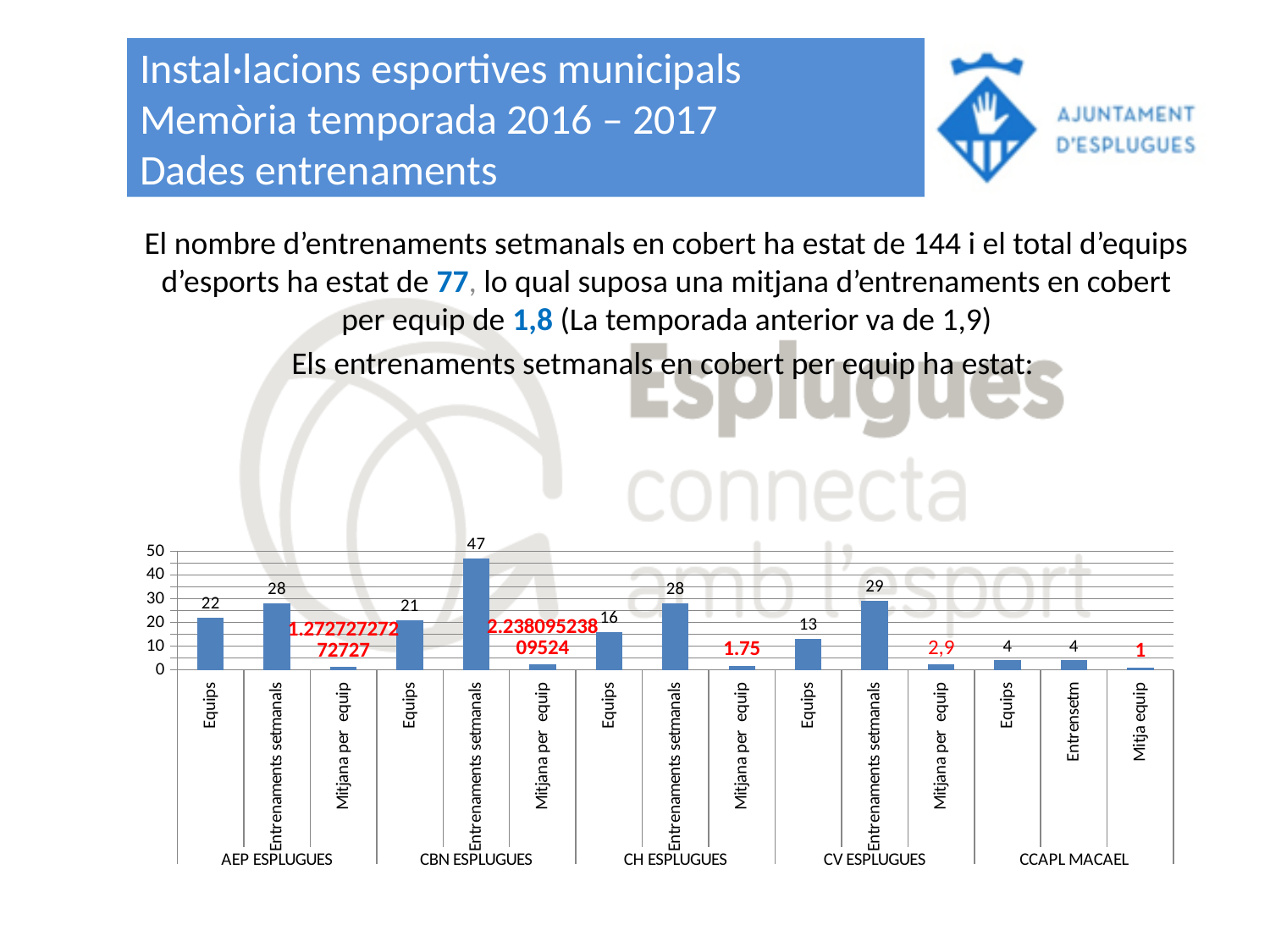
Which club has the highest value for Entrenaments setmanals? CBN ESPLUGUES What is the value for Entrensetm for CCAPL MACAEL? 4 What is the value for Equips for CV ESPLUGUES? 13 What kind of chart is shown on the slide? bar chart What is the difference between Entrenaments setmanals and Equips for CBN ESPLUGUES? 26 Which is larger: Equips for AEP ESPLUGUES or Equips for CH ESPLUGUES? Equips for AEP ESPLUGUES How many clubs are shown on the x axis of the chart? 5 Which club has the lowest value for Equips? CCAPL MACAEL What is the value for Mitjana per equip for CH ESPLUGUES? 1.75 Is the value for Entrenaments setmanals for CV ESPLUGUES greater or less than 20? greater What is the value for Entrenaments setmanals for CBN ESPLUGUES? 47 What is the value for Equips for AEP ESPLUGUES? 22